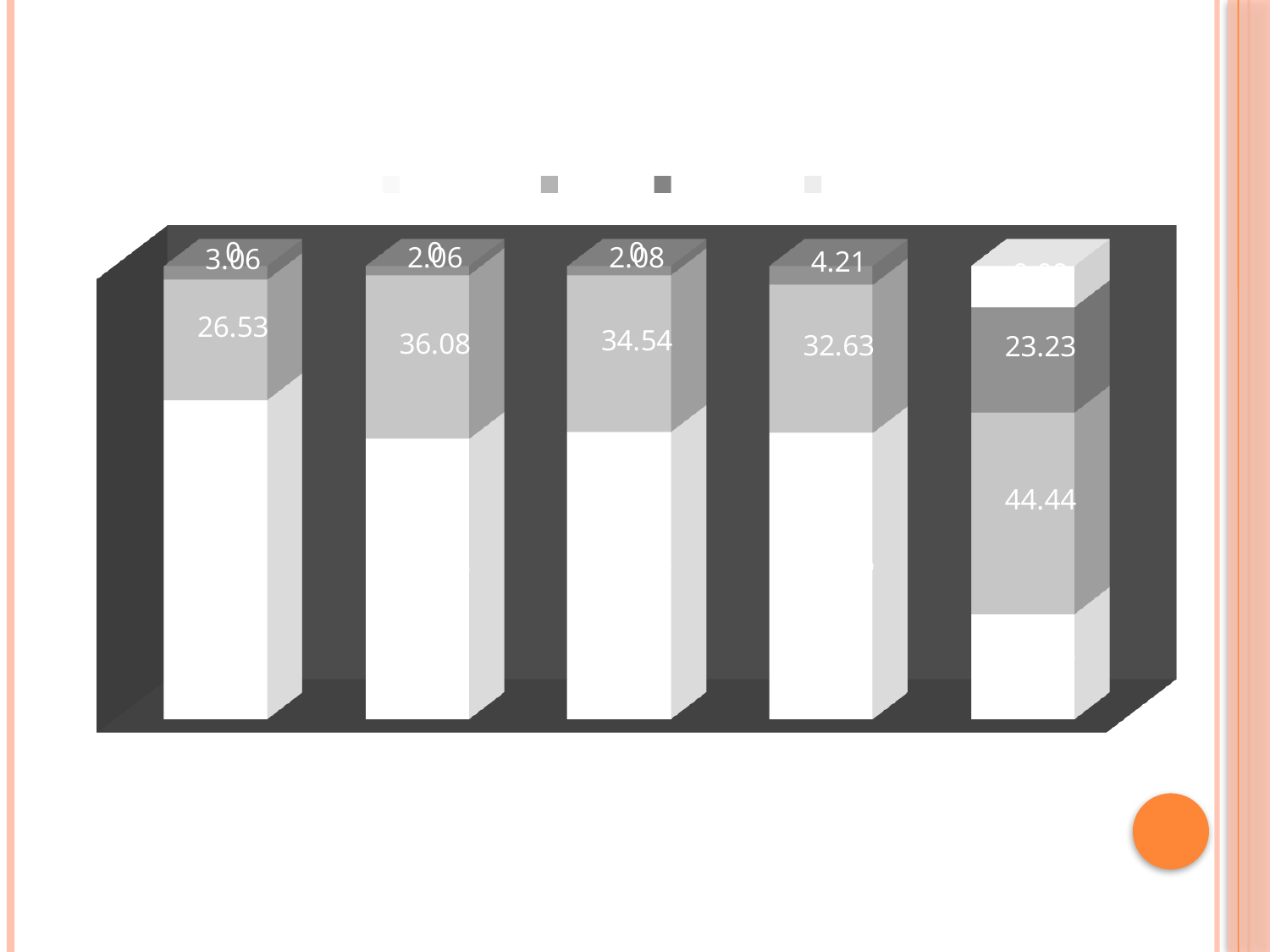
What value is printed on the dark grey segment of the rightmost bar? 23.23 What value is printed on the light grey segment of the middle bar? 34.54 What value is printed on the light grey segment of the second bar from the left? 36.08 What value is printed on the light grey segment of the fourth bar from the left? 32.63 What value is printed on the top segment of the fourth bar from the left? 4.21 What value is printed on the light grey segment of the rightmost bar? 44.44 What kind of chart is shown on the slide? stacked bar chart Which is larger: the light grey segment of the second bar (36.08) or the light grey segment of the middle bar (34.54)? the second bar (36.08) What is the difference between the light grey segment values of the second bar (36.08) and the leftmost bar (26.53)? 9.55 How many series does the legend list? 4 What value is printed on the light grey segment of the leftmost bar? 26.53 How many bars are plotted in the chart? 5